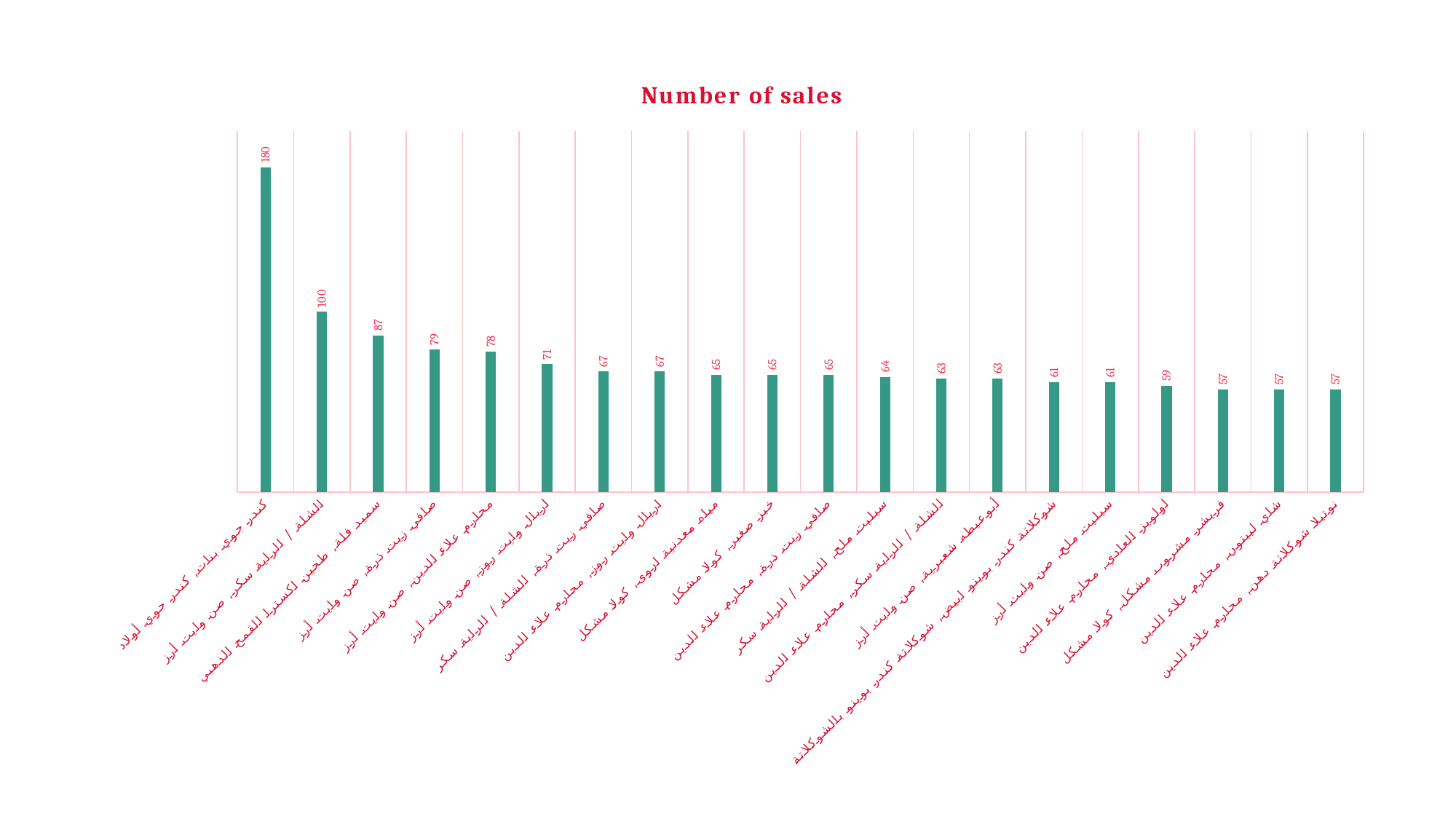
What is the lowest value shown in the chart? 57 What is the title of the chart? Number of sales What is the difference between the first bar (180) and the second bar (100)? 80 How many bars (categories) are plotted in the chart? 20 What is the value of the last (rightmost) bar? 57 What is the highest value shown in the chart? 180 Which is larger, the value of the fourth bar or the value of the fifth bar? The fourth bar (79) What is the value of the first (leftmost) bar, labelled كندر جوي بنات، كندر جوي أولاد? 180 What type of chart is shown on the slide? Bar chart What is the value of the third bar, labelled سميد فلة، طحين اكسترا القمح الذهبي? 87 Do the values generally rise or fall moving from left to right along the x axis? Fall What is the value of the second bar from the left? 100